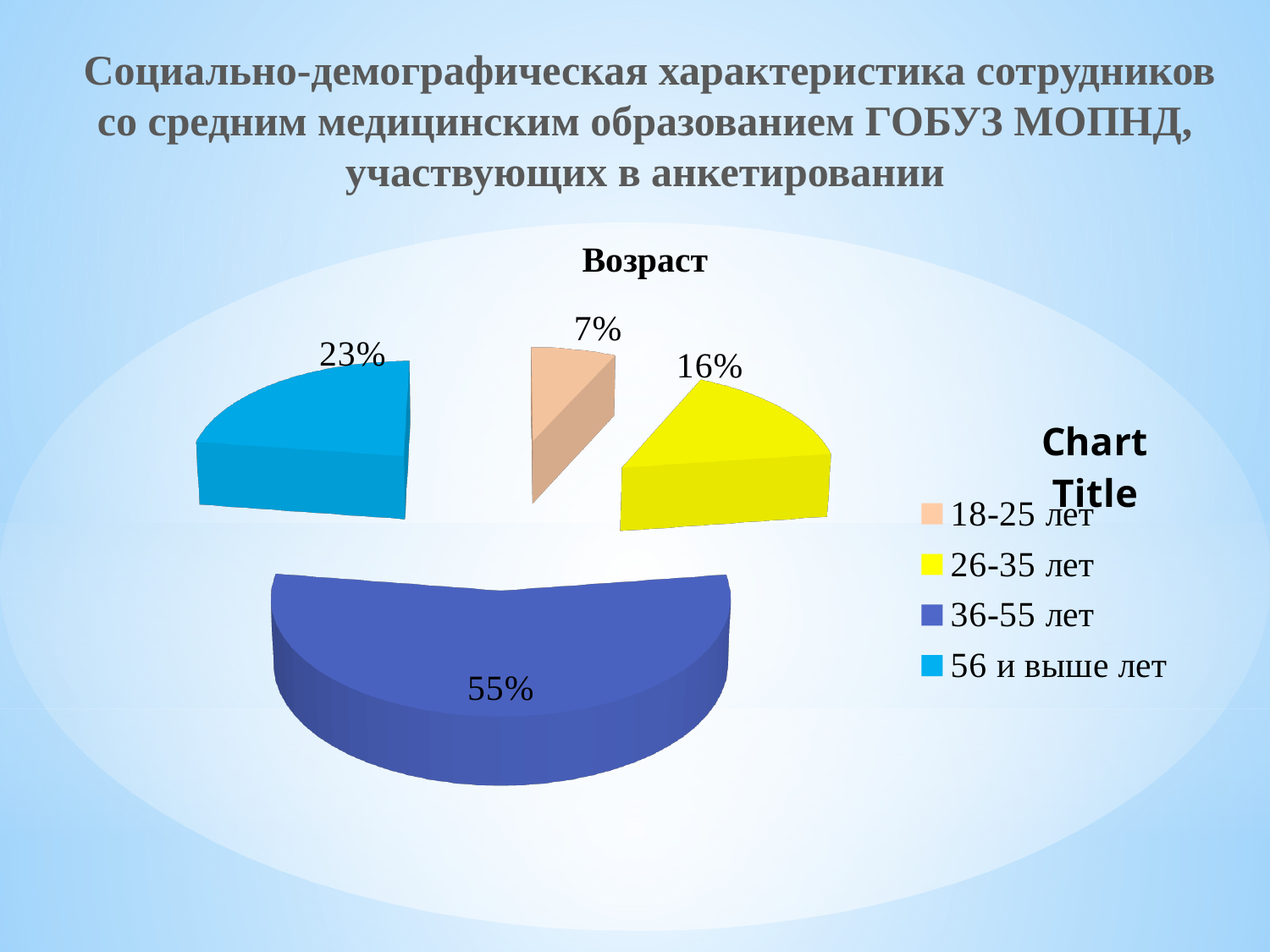
Which slice is larger: 26-35 лет or 56 и выше лет? 56 и выше лет What percentage of the pie is the 26-35 лет slice? 16% What is the title of the chart? Возраст What percentage of the pie is the 18-25 лет slice? 7% What kind of chart is shown on the slide? pie chart What percentage of the pie is the 36-55 лет slice? 55% What colour is the 36-55 лет slice? blue What percentage of the pie is the 56 и выше лет slice? 23% How many slices does the pie chart have? 4 What is the difference in percentage points between the 56 и выше лет slice and the 26-35 лет slice? 7 Which age group has the smallest share of the pie? 18-25 лет Which age group has the largest share of the pie? 36-55 лет